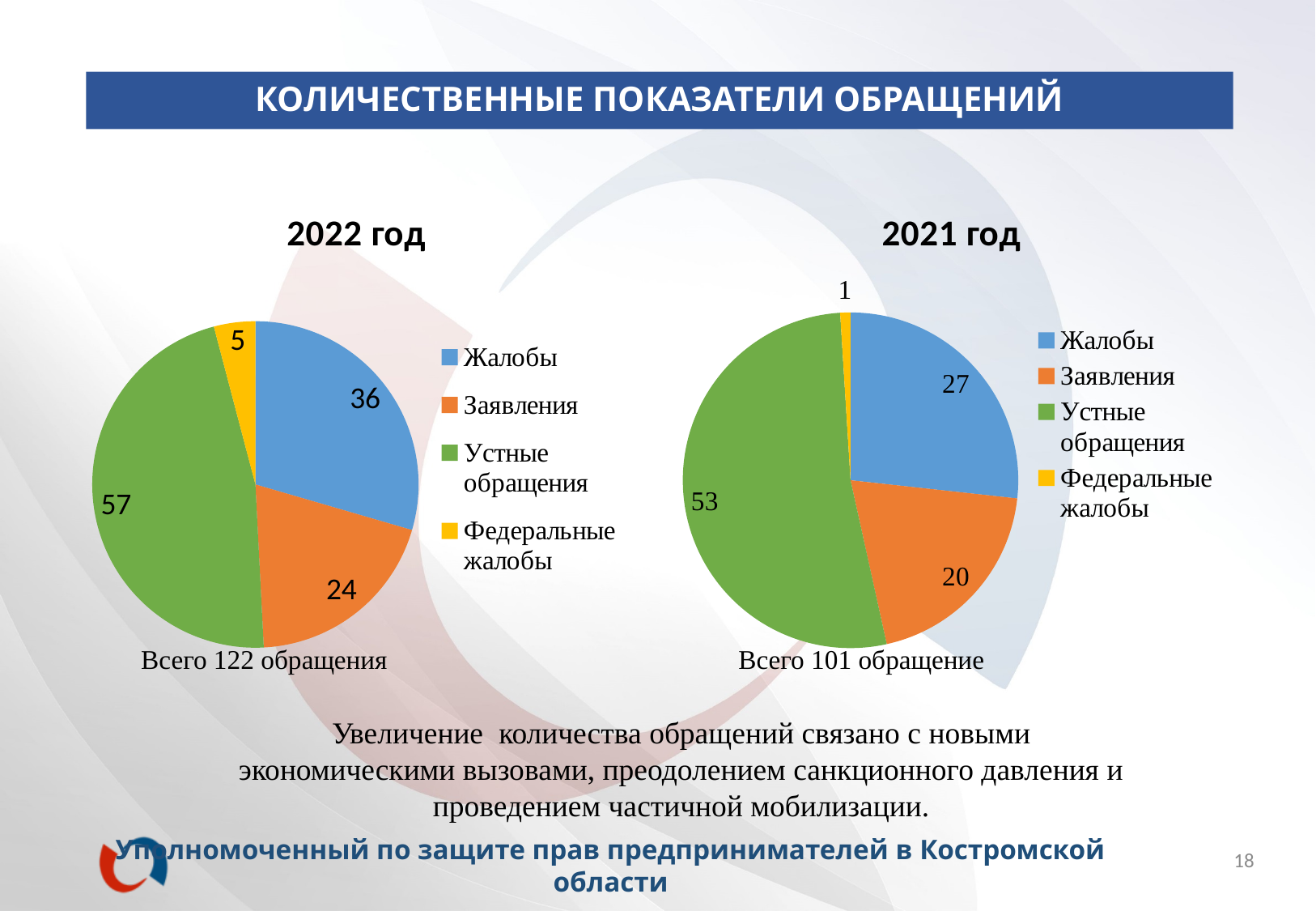
In the 2022 год chart, what is the difference between Жалобы and Заявления? 12 In the 2021 год chart, which is larger, Жалобы or Заявления? Жалобы In the 2022 год chart, which category has the largest value? Устные обращения What is the total number of обращения shown for the 2022 год chart? 122 In the 2022 год chart, which colour represents Заявления? orange What kind of chart is the 2022 год chart? pie chart In the 2022 год chart, what is the value for Федеральные жалобы? 5 In the 2021 год chart, which category has the smallest value? Федеральные жалобы In the 2021 год chart, what is the value for Устные обращения? 53 In the 2022 год chart, what is the value for Жалобы? 36 How many categories does the 2021 год chart show? 4